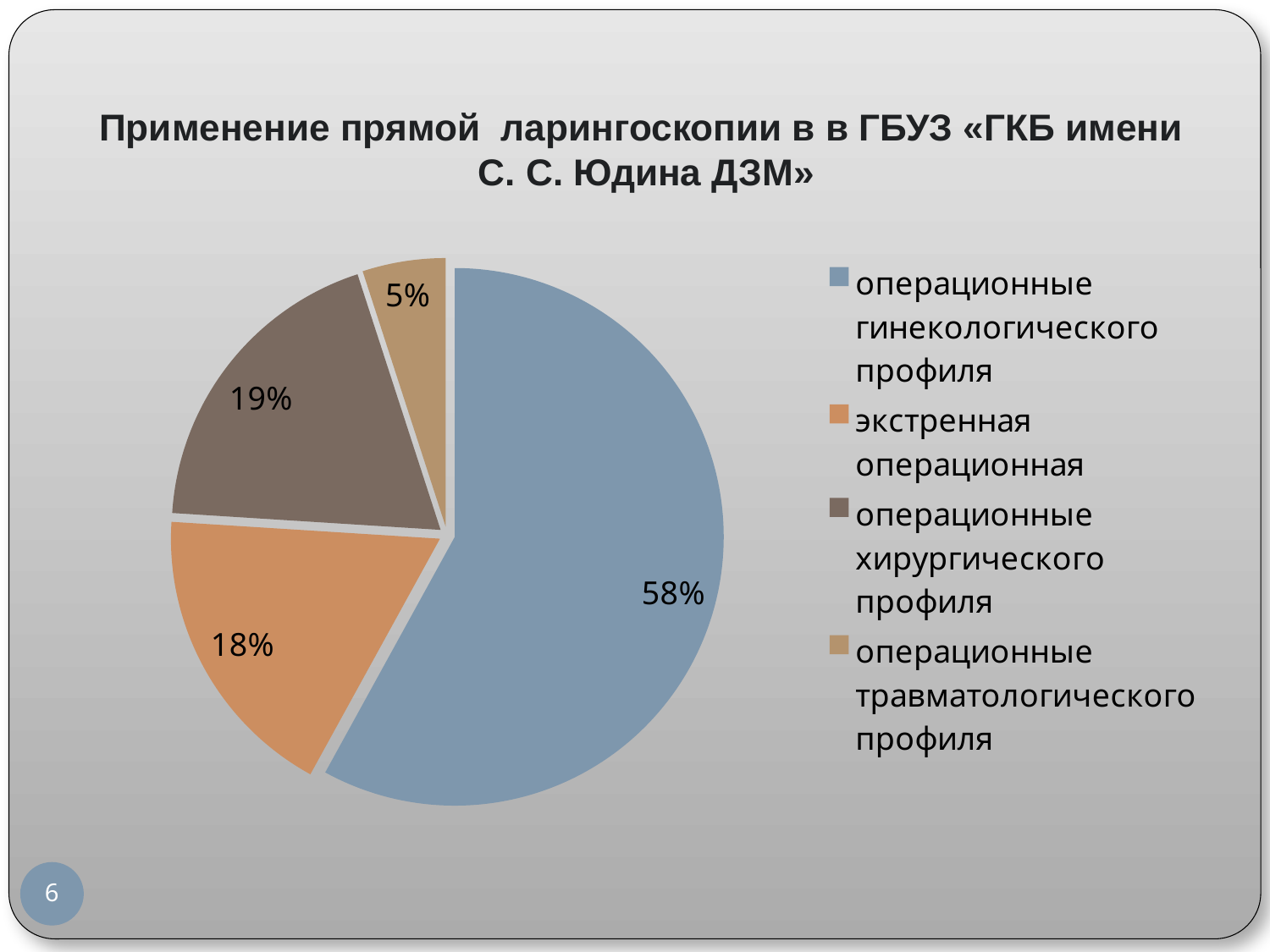
How many entries does the legend list? 4 What is the difference in percentage points between операционные гинекологического профиля and операционные хирургического профиля? 39 What share of the pie is labelled for экстренная операционная? 18% Which is larger: the slice for операционные хирургического профиля or the slice for операционные травматологического профиля? операционные хирургического профиля What share of the pie is labelled for операционные травматологического профиля? 5% How many slices does the pie chart have? 4 What share of the pie is labelled for операционные хирургического профиля? 19% Which category has the smallest slice of the pie? операционные травматологического профиля What colour is the slice for экстренная операционная? orange What share of the pie is labelled for операционные гинекологического профиля? 58% Which category has the largest slice of the pie? операционные гинекологического профиля What type of chart is shown on the slide? pie chart